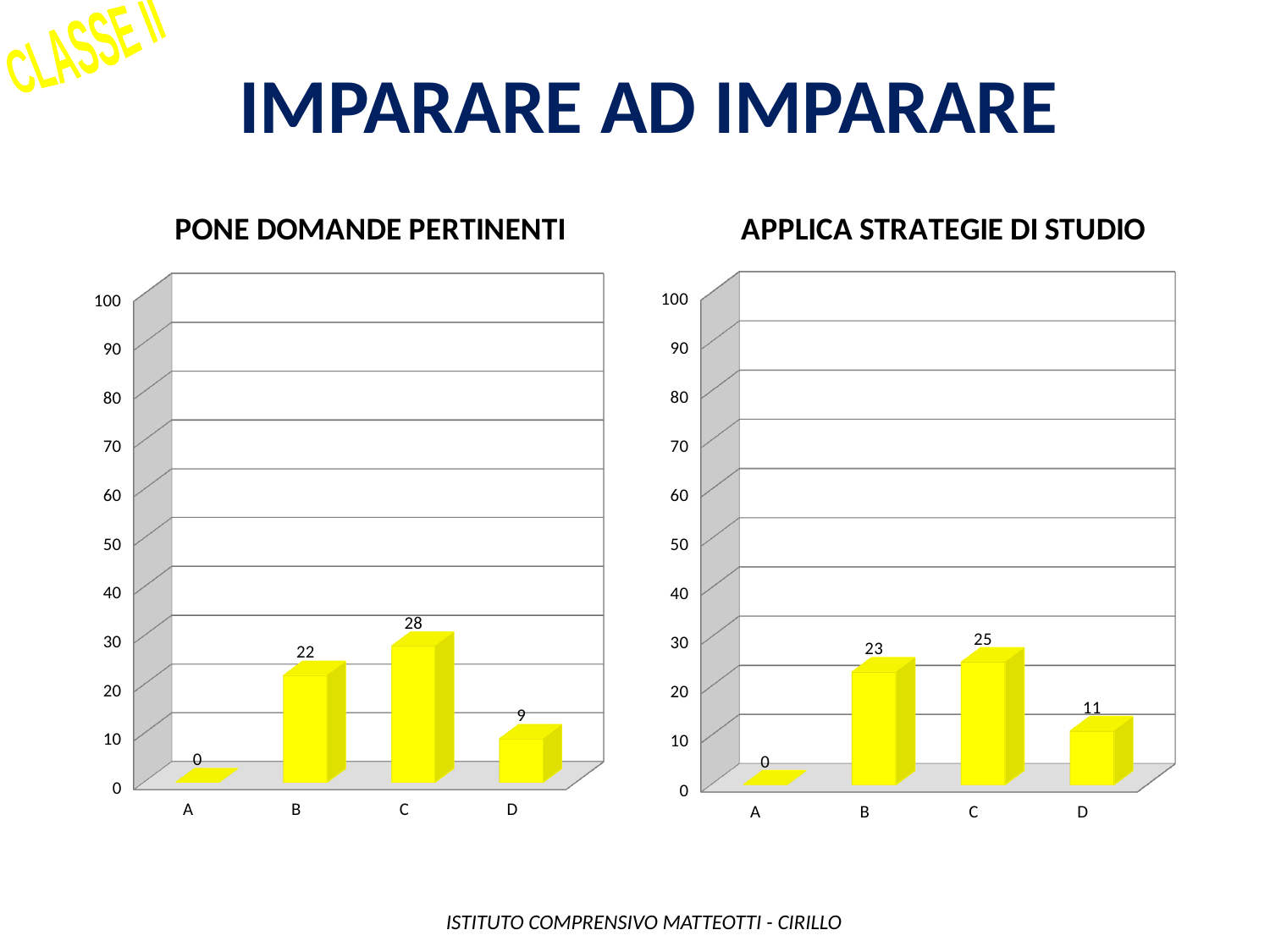
In the 'PONE DOMANDE PERTINENTI' chart, what is the difference between the values for C and B? 6 What kind of chart is the 'PONE DOMANDE PERTINENTI' chart? bar chart In the 'PONE DOMANDE PERTINENTI' chart, is the value for D greater or less than 20? less In the 'PONE DOMANDE PERTINENTI' chart, which category has the highest value? C In the 'APPLICA STRATEGIE DI STUDIO' chart, which category has the lowest value? A In the 'PONE DOMANDE PERTINENTI' chart, what is the value for category C? 28 In the 'APPLICA STRATEGIE DI STUDIO' chart, what is the value for category D? 11 What is the title of the chart on the right side of the slide? APPLICA STRATEGIE DI STUDIO How many categories are shown in the 'APPLICA STRATEGIE DI STUDIO' chart? 4 In the 'APPLICA STRATEGIE DI STUDIO' chart, what is the difference between the values for B and D? 12 In the 'PONE DOMANDE PERTINENTI' chart, what is the value for category A? 0 In the 'APPLICA STRATEGIE DI STUDIO' chart, which is larger, the value for B or the value for C? C